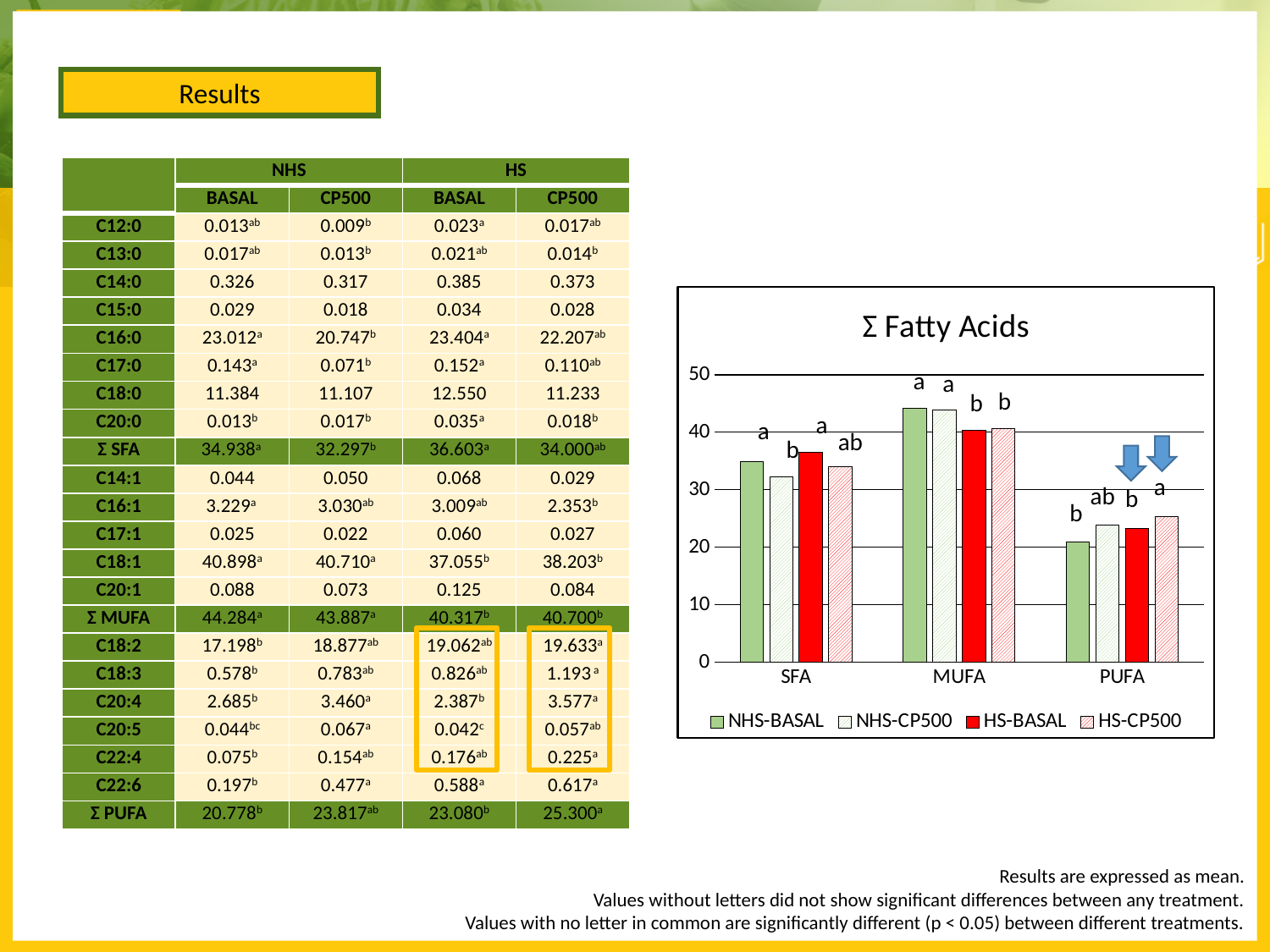
Is the value for NHS-BASAL in the MUFA category greater or less than 40? greater For the NHS-BASAL series, which category has the lowest bar? PUFA In the PUFA category, which series has the lowest bar? NHS-BASAL Which series is drawn in solid red in the chart? HS-BASAL How many categories are shown on the x axis of the chart? 3 For the NHS-BASAL series, which category has the highest bar? MUFA For the HS-BASAL series, which is larger: the SFA value or the MUFA value? MUFA Is the value for HS-BASAL in the SFA category greater or less than 30? greater What is the title of the chart? Σ Fatty Acids What kind of chart is shown on the slide? bar chart Is the value for NHS-BASAL in the PUFA category greater or less than 30? less How many series does the chart legend list? 4